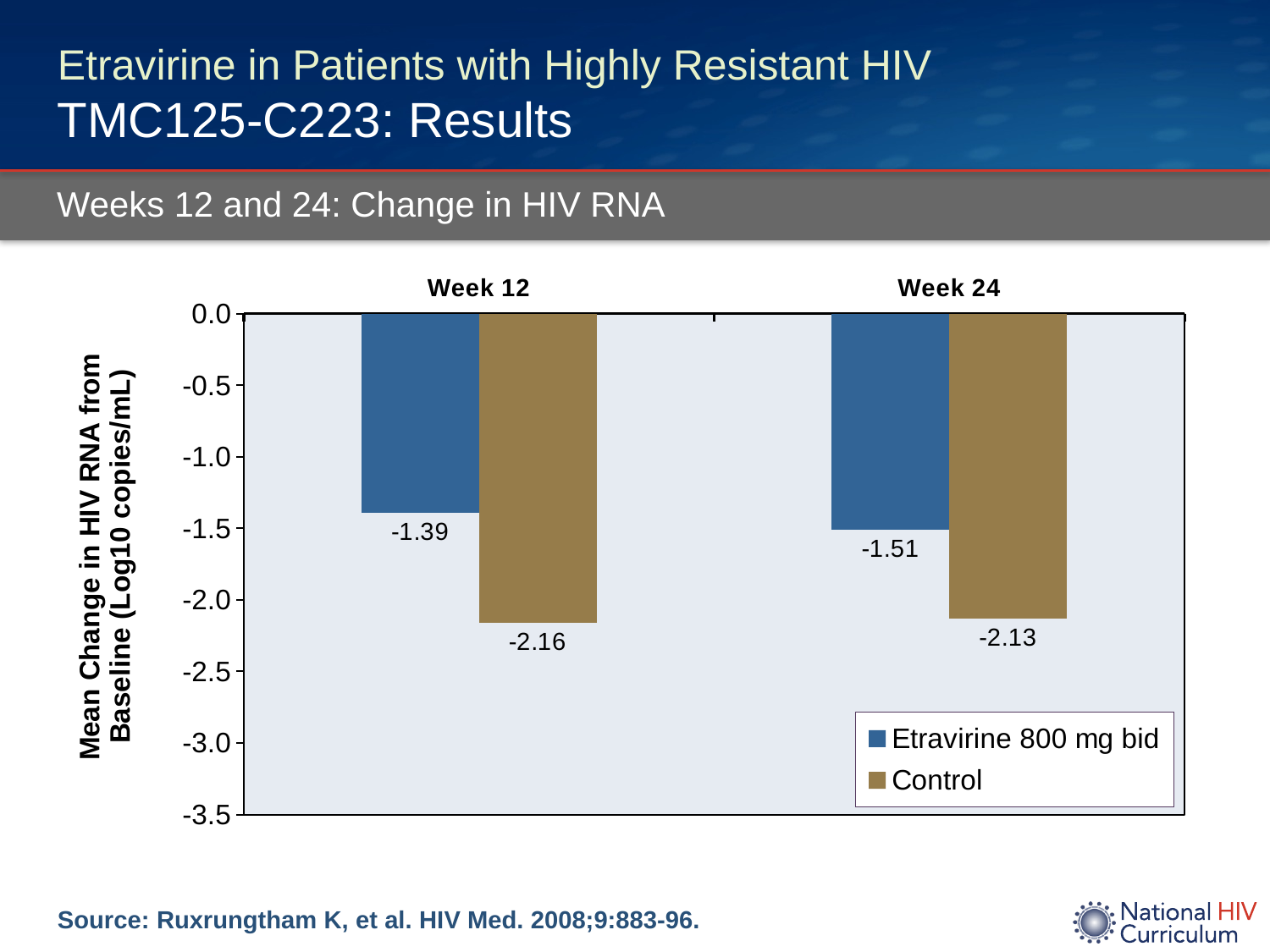
What is the difference between the Control and Etravirine 800 mg bid values at Week 12? 0.77 What is the mean change in HIV RNA for Etravirine 800 mg bid at Week 12? -1.39 What kind of chart is shown on the slide? Bar chart At Week 24, which group shows a larger decrease in HIV RNA from baseline, Etravirine 800 mg bid or Control? Control What is the mean change in HIV RNA for Control at Week 12? -2.16 Which bar shows the smallest decrease in HIV RNA from baseline (the least negative value)? Etravirine 800 mg bid at Week 12 What is the mean change in HIV RNA for Control at Week 24? -2.13 Which bar shows the largest decrease in HIV RNA from baseline (the most negative value)? Control at Week 12 What is the mean change in HIV RNA for Etravirine 800 mg bid at Week 24? -1.51 How many time points (categories) are shown on the x axis? 2 What is the difference between the Control and Etravirine 800 mg bid values at Week 24? 0.62 How many series does the legend list? 2